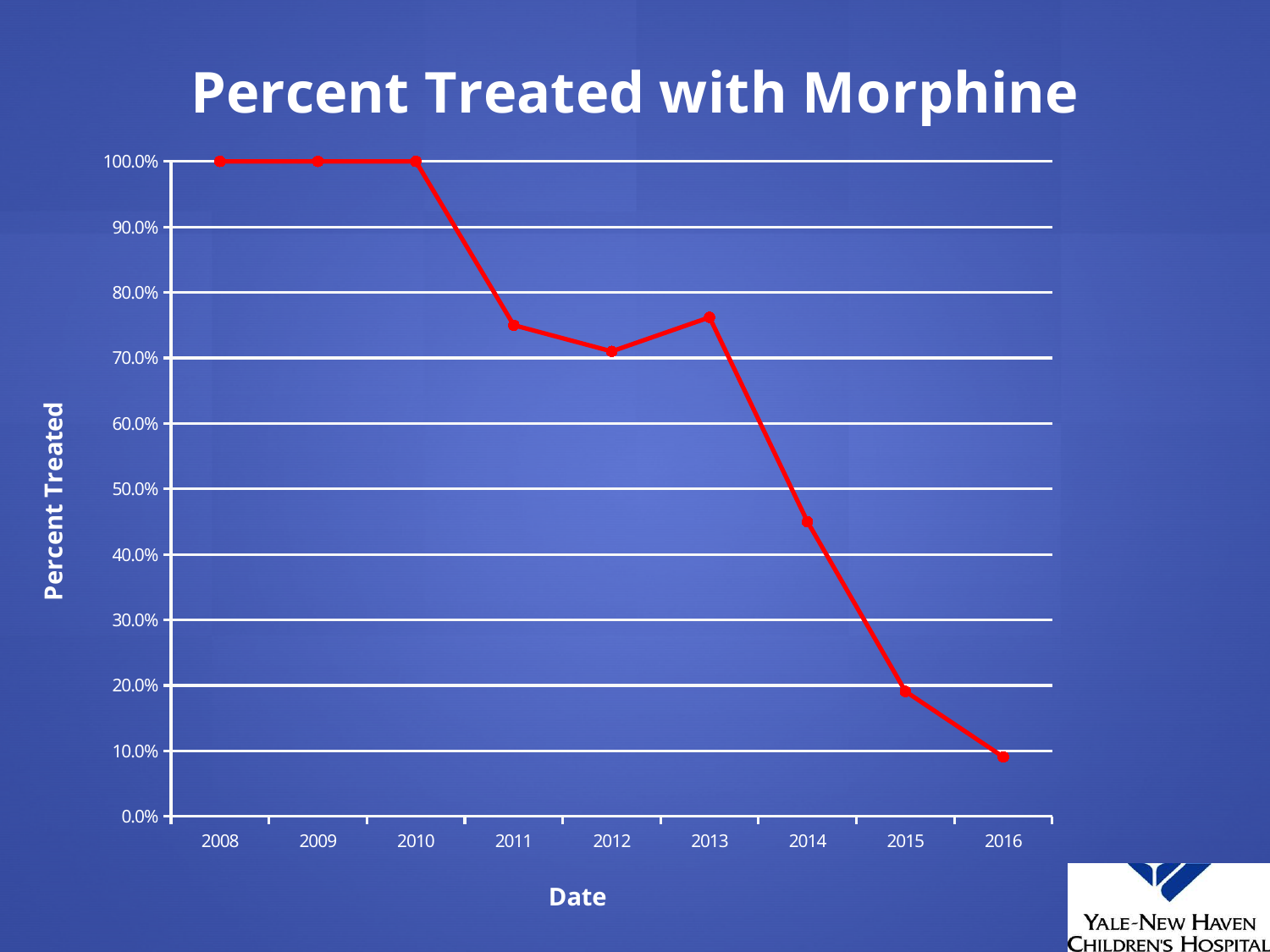
How many years are plotted on the x axis? 9 Which year has the larger value, 2014 or 2015? 2014 What is the value for 2008? 100.0% What type of chart is shown on the slide? line chart Is the value for 2011 greater or less than 70.0%? greater What is the title of the chart? Percent Treated with Morphine What is the value for 2010? 100.0% Is the value for 2014 greater or less than 50.0%? less Which year has the lowest percent treated? 2016 Overall, do the values rise or fall from 2008 to 2016? fall What is the label on the vertical axis of the chart? Percent Treated